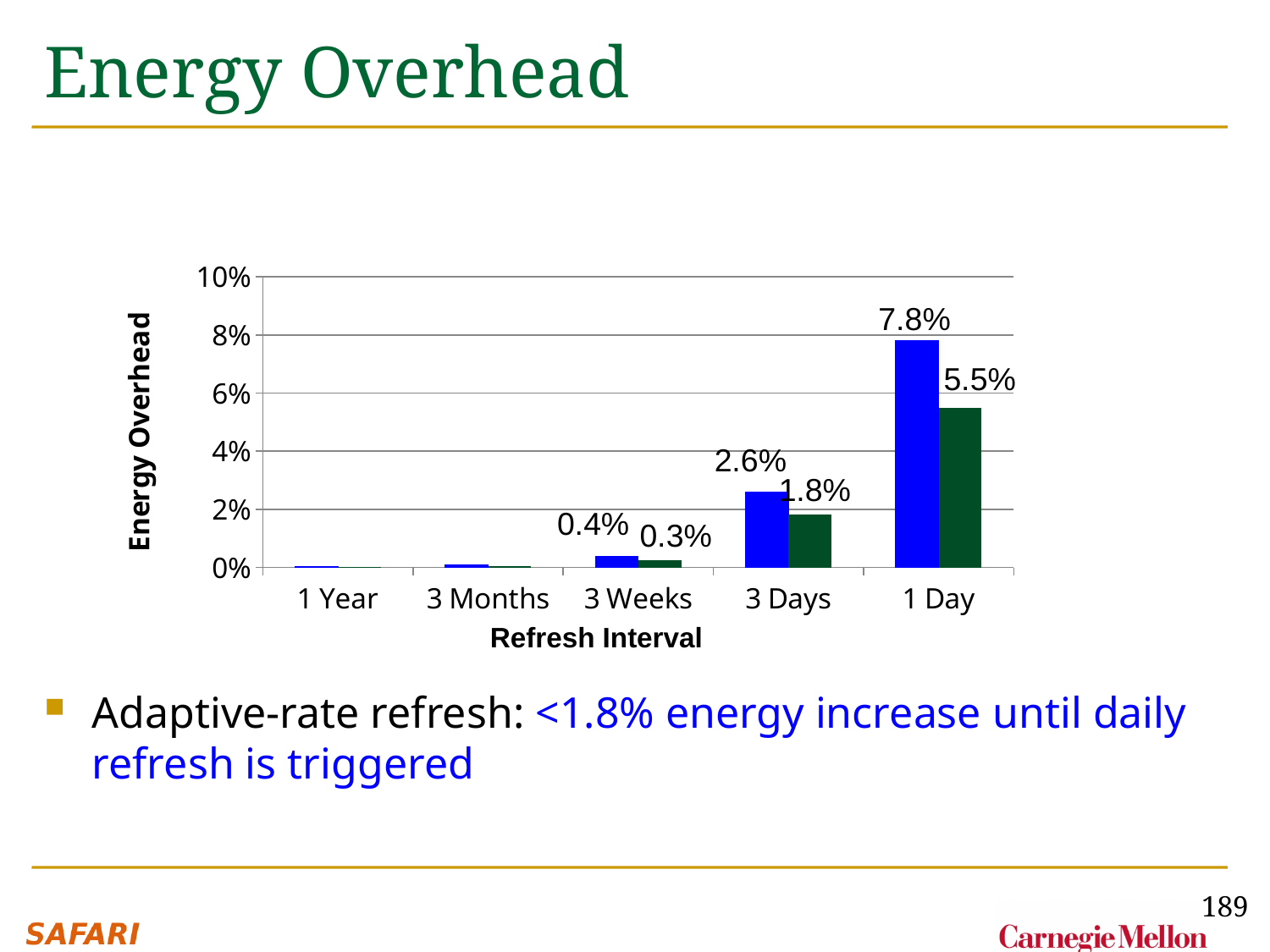
What is the energy overhead of the blue bar for the 1 Day refresh interval? 7.8% What is the energy overhead of the dark green bar for the 1 Day refresh interval? 5.5% Which is larger for the 3 Days refresh interval, the blue bar or the dark green bar? the blue bar What is the difference between the blue and dark green bars for the 1 Day refresh interval? 2.3% What type of chart is shown on the slide? bar chart What is the energy overhead of the blue bar for the 3 Days refresh interval? 2.6% What is the energy overhead of the dark green bar for the 3 Weeks refresh interval? 0.3% Is the blue bar for the 1 Day refresh interval greater or less than 6%? greater What is the difference between the blue bars for 1 Day and 3 Days? 5.2% What is the label of the y axis? Energy Overhead Which refresh interval has the highest energy overhead? 1 Day How many refresh intervals are shown on the x axis? 5